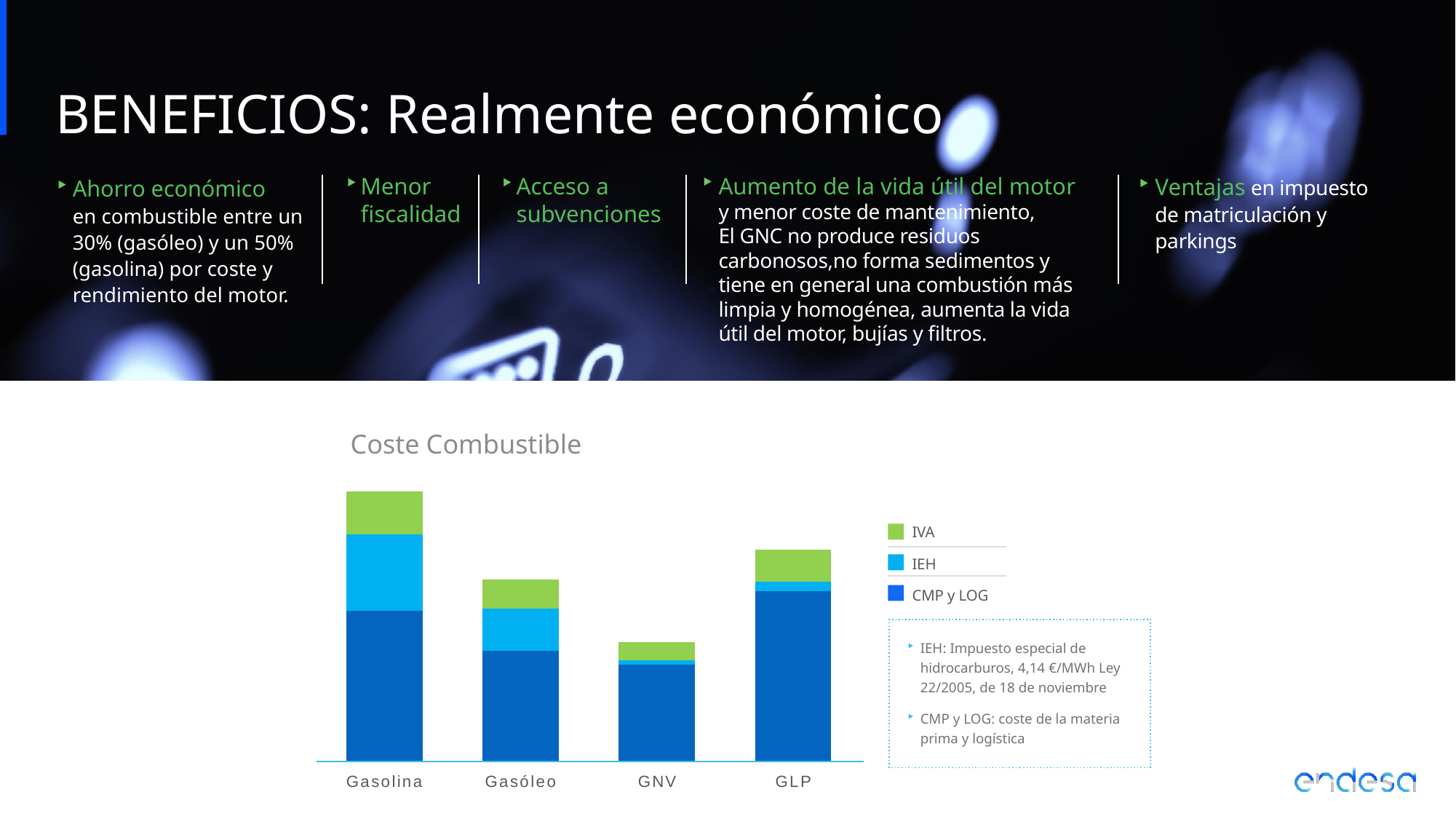
In the 'Coste Combustible' chart, which fuel has the largest 'CMP y LOG' segment? GLP What kind of chart is the 'Coste Combustible' chart? Stacked bar chart What is the title of the chart on the slide? Coste Combustible Which series in the 'Coste Combustible' chart is shown in green? IVA In the 'Coste Combustible' chart, is the total bar for Gasolina or for GNV taller? Gasolina How many series does the legend of the 'Coste Combustible' chart list? 3 Which fuel has the shortest stacked bar in the 'Coste Combustible' chart? GNV In the 'Coste Combustible' chart, which fuel has the largest 'IEH' segment? Gasolina In the 'Coste Combustible' chart, is the total bar for Gasóleo or for GLP taller? GLP In the 'Coste Combustible' chart, is the 'IEH' segment larger for Gasolina or for GLP? Gasolina How many fuel categories are shown on the x axis of the 'Coste Combustible' chart? 4 Which fuel has the tallest stacked bar in the 'Coste Combustible' chart? Gasolina